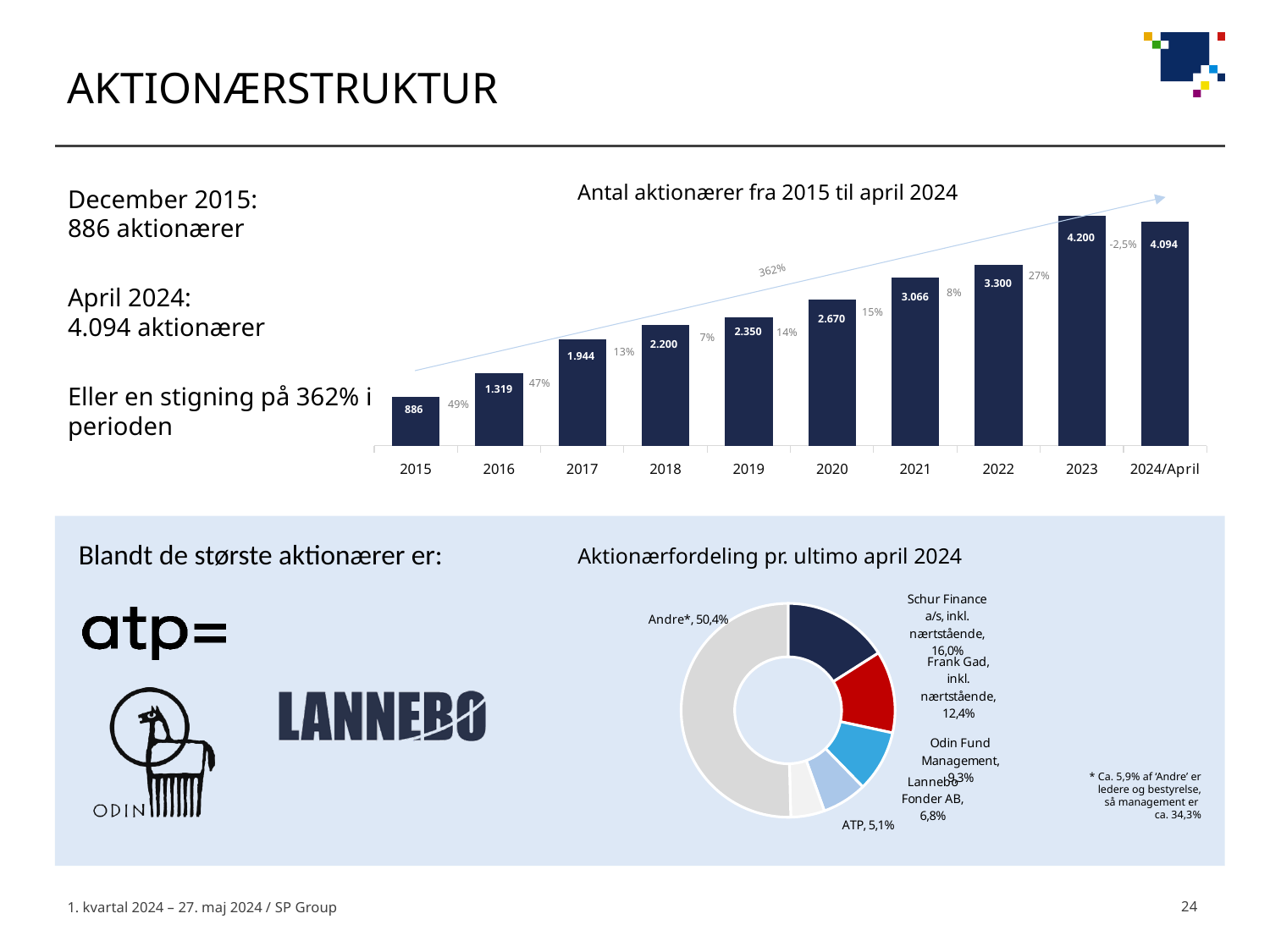
In the chart 'Antal aktionærer fra 2015 til april 2024', what percentage change is shown between 2023 and 2024/April? -2,5% In the chart 'Aktionærfordeling pr. ultimo april 2024', what is the difference between the shares of Frank Gad, inkl. nærtstående and Odin Fund Management? 3,1% In the chart 'Antal aktionærer fra 2015 til april 2024', which is larger, the value for 2019 or the value for 2020? 2020 In the chart 'Antal aktionærer fra 2015 til april 2024', what is the difference between the values for 2023 and 2022? 900 What kind of chart is 'Antal aktionærer fra 2015 til april 2024'? Bar chart In the chart 'Antal aktionærer fra 2015 til april 2024', which year has the lowest number of shareholders? 2015 In the chart 'Aktionærfordeling pr. ultimo april 2024', which named shareholder (excluding Andre*) has the largest share? Schur Finance a/s, inkl. nærtstående In the chart 'Antal aktionærer fra 2015 til april 2024', which year has the highest number of shareholders? 2023 How many years (categories) are shown in the chart 'Antal aktionærer fra 2015 til april 2024'? 10 In the chart 'Aktionærfordeling pr. ultimo april 2024', what share does ATP hold? 5,1% In the chart 'Antal aktionærer fra 2015 til april 2024', what is the value for 2024/April? 4.094 In the chart 'Antal aktionærer fra 2015 til april 2024', what is the value for 2015? 886